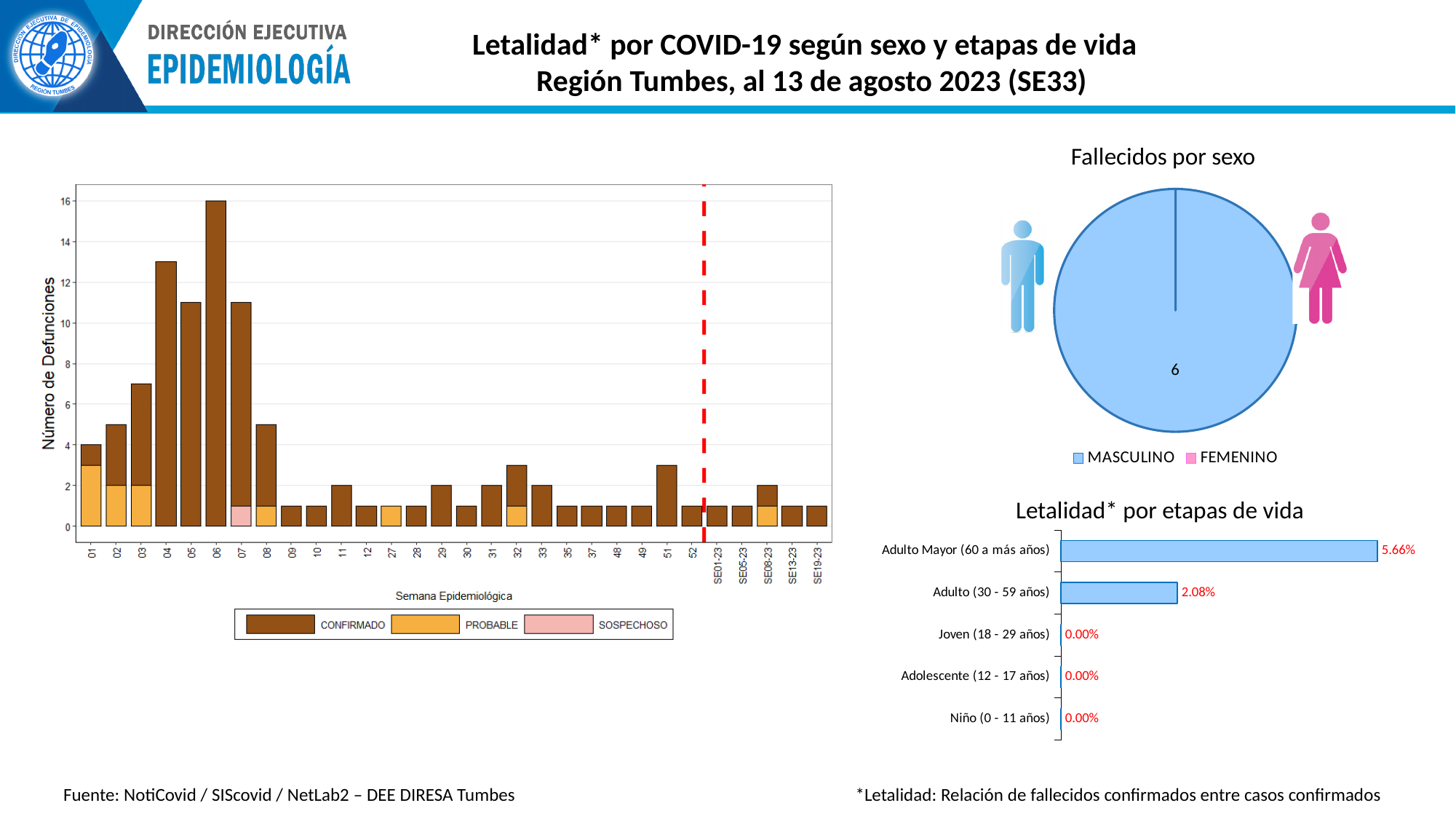
In the bar chart on the left showing Número de Defunciones by Semana Epidemiológica, which week has the highest number of deaths? 06 In the pie chart titled 'Fallecidos por sexo', what value is shown for MASCULINO? 6 In the chart titled 'Letalidad* por etapas de vida', what is the value for Joven (18 - 29 años)? 0.00% In the chart titled 'Letalidad* por etapas de vida', what is the difference between the values for Adulto Mayor (60 a más años) and Adulto (30 - 59 años)? 3.58% In the pie chart titled 'Fallecidos por sexo', how many categories does the legend list? 2 In the chart titled 'Letalidad* por etapas de vida', what is the value for Adulto Mayor (60 a más años)? 5.66% In the bar chart on the left showing Número de Defunciones by Semana Epidemiológica, is the total value for week 04 greater or less than 12? greater What kind of chart is the chart titled 'Letalidad* por etapas de vida'? bar chart In the chart titled 'Letalidad* por etapas de vida', what is the value for Adulto (30 - 59 años)? 2.08% In the chart titled 'Letalidad* por etapas de vida', how many age groups are shown? 5 In the bar chart on the left showing Número de Defunciones by Semana Epidemiológica, how many series does the legend list? 3 In the chart titled 'Letalidad* por etapas de vida', which age group has the highest value? Adulto Mayor (60 a más años)